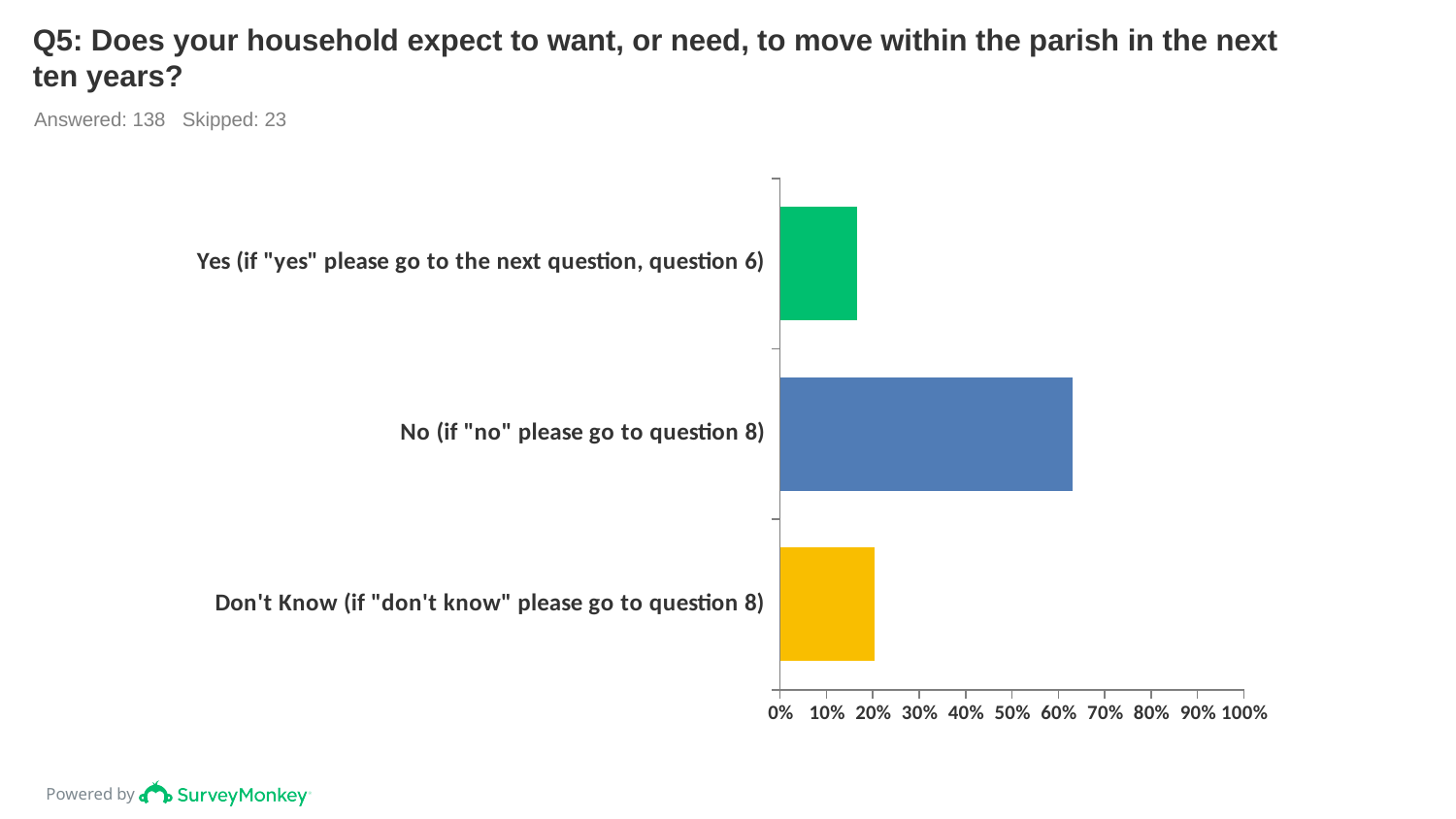
How many categories are plotted in the chart? 3 Is the value for "Don't Know" greater or less than 10%? greater Which is larger, the value for "No" or the value for "Yes"? No Is the value for "No" greater or less than 60%? greater Is the value for "Yes" greater or less than 20%? less What colour is the bar for "No"? blue Which category has the highest value? No (if "no" please go to question 8) Which is larger, the value for "Don't Know" or the value for "No"? No What kind of chart is shown on the slide? bar chart Which category has the lowest value? Yes (if "yes" please go to the next question, question 6) How many respondents answered this question according to the slide? 138